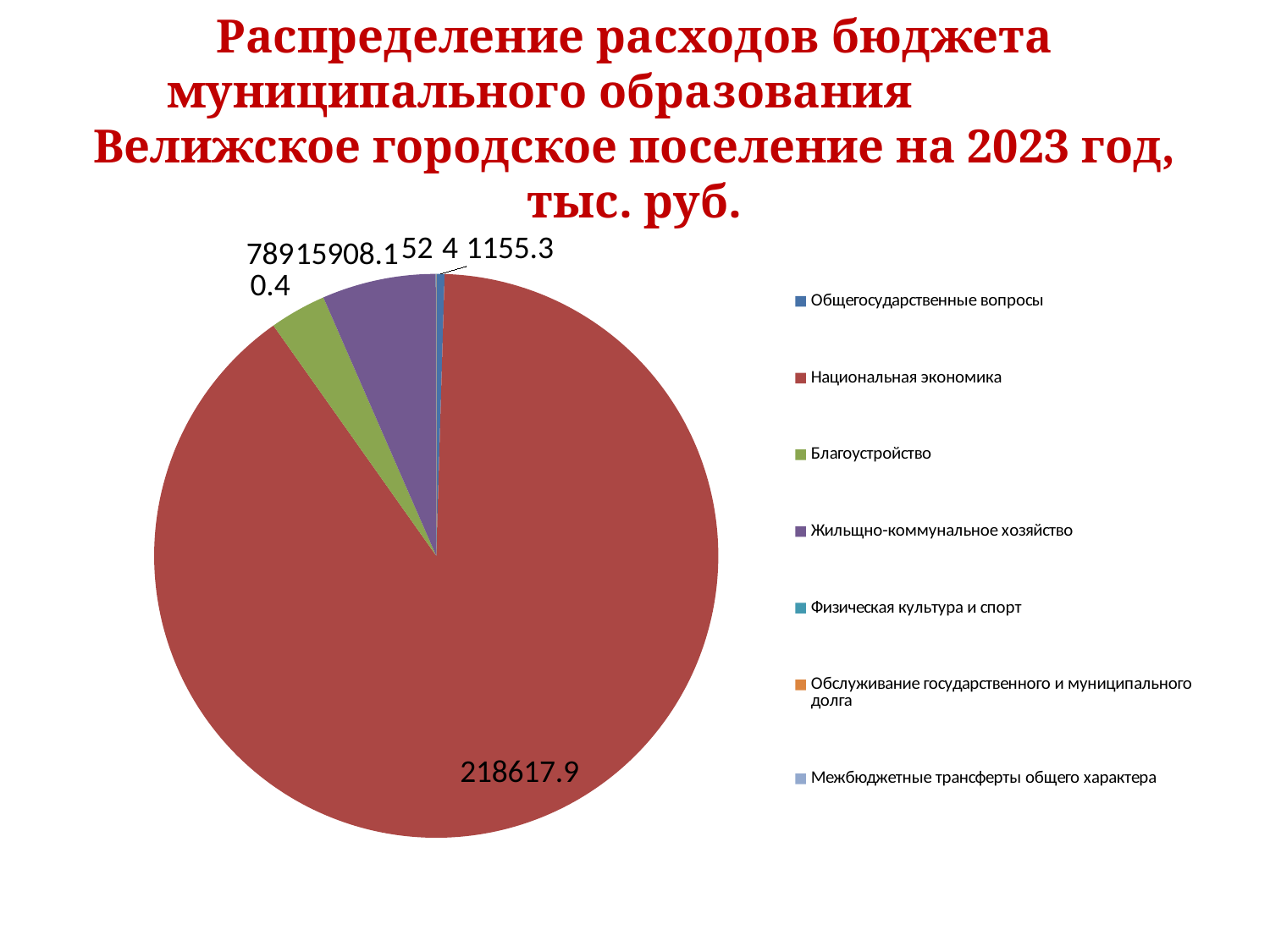
Which category is listed first in the legend? Общегосударственные вопросы What type of chart is shown on the slide? pie chart Does the slice for Национальная экономика take up more or less than half of the pie? more What colour is the slice for Национальная экономика? red Which slice is larger: Национальная экономика or Жильщно-коммунальное хозяйство? Национальная экономика Which category has the largest slice of the pie? Национальная экономика Which slice is larger: Благоустройство or Общегосударственные вопросы? Благоустройство What is the value shown for Национальная экономика? 218617.9 Which slice is larger: Жильщно-коммунальное хозяйство or Благоустройство? Жильщно-коммунальное хозяйство How many categories does the legend of the pie chart list? 7